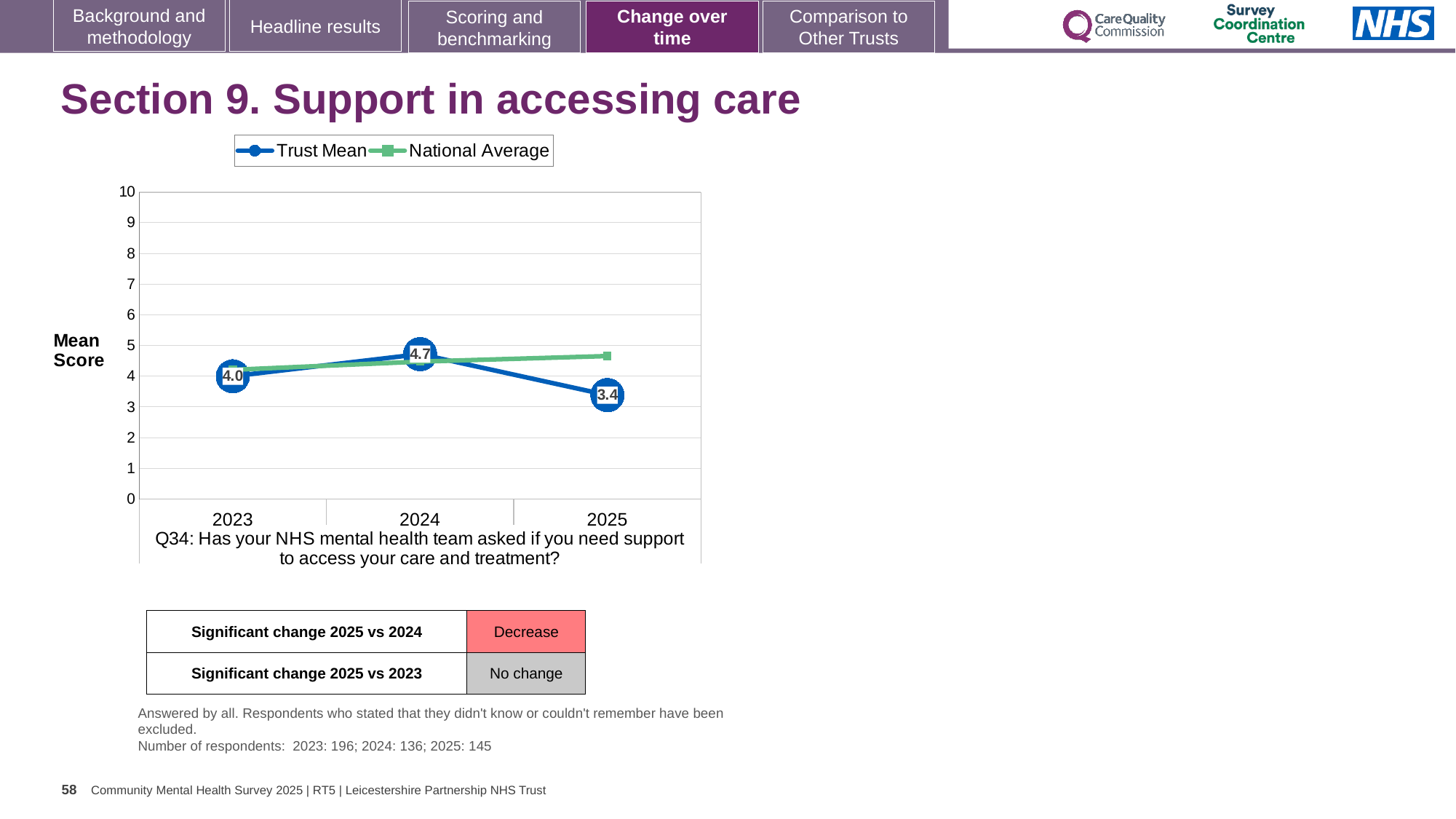
In which year is the Trust Mean highest? 2024 How many series does the legend list? 2 Is the National Average value for 2025 greater or less than 4? greater In 2025, which is higher, the Trust Mean or the National Average? National Average In which year is the Trust Mean lowest? 2025 What is the Trust Mean score for 2023? 4.0 What is the Trust Mean score for 2025? 3.4 How many years are plotted on the x axis? 3 What is the difference between the Trust Mean in 2024 and in 2025? 1.3 Which is larger, the Trust Mean in 2023 or in 2025? 2023 What kind of chart is shown on the slide? Line chart What is the Trust Mean score for 2024? 4.7